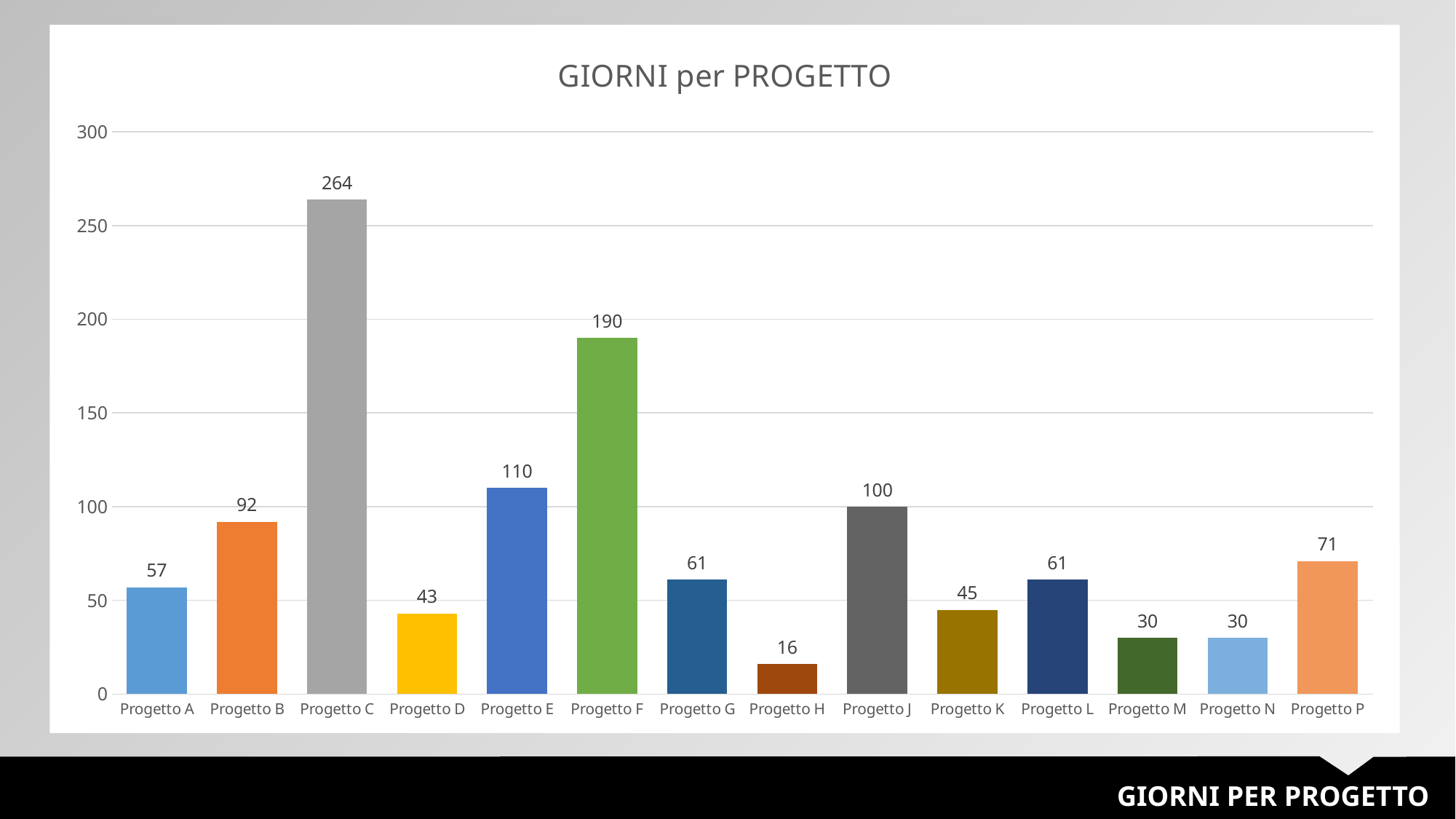
Which project has the highest value? Progetto C Which project has the lowest value? Progetto H What is the difference between the values for Progetto C and Progetto F? 74 Which is larger, the value for Progetto B or the value for Progetto P? Progetto B What is the title of the chart? GIORNI per PROGETTO What is the difference between the values for Progetto E and Progetto J? 10 Is the value for Progetto F greater or less than 150? greater What is the value for Progetto P? 71 What kind of chart is shown on the slide? Bar chart What is the value for Progetto H? 16 How many projects are shown on the chart? 14 What is the value for Progetto C? 264